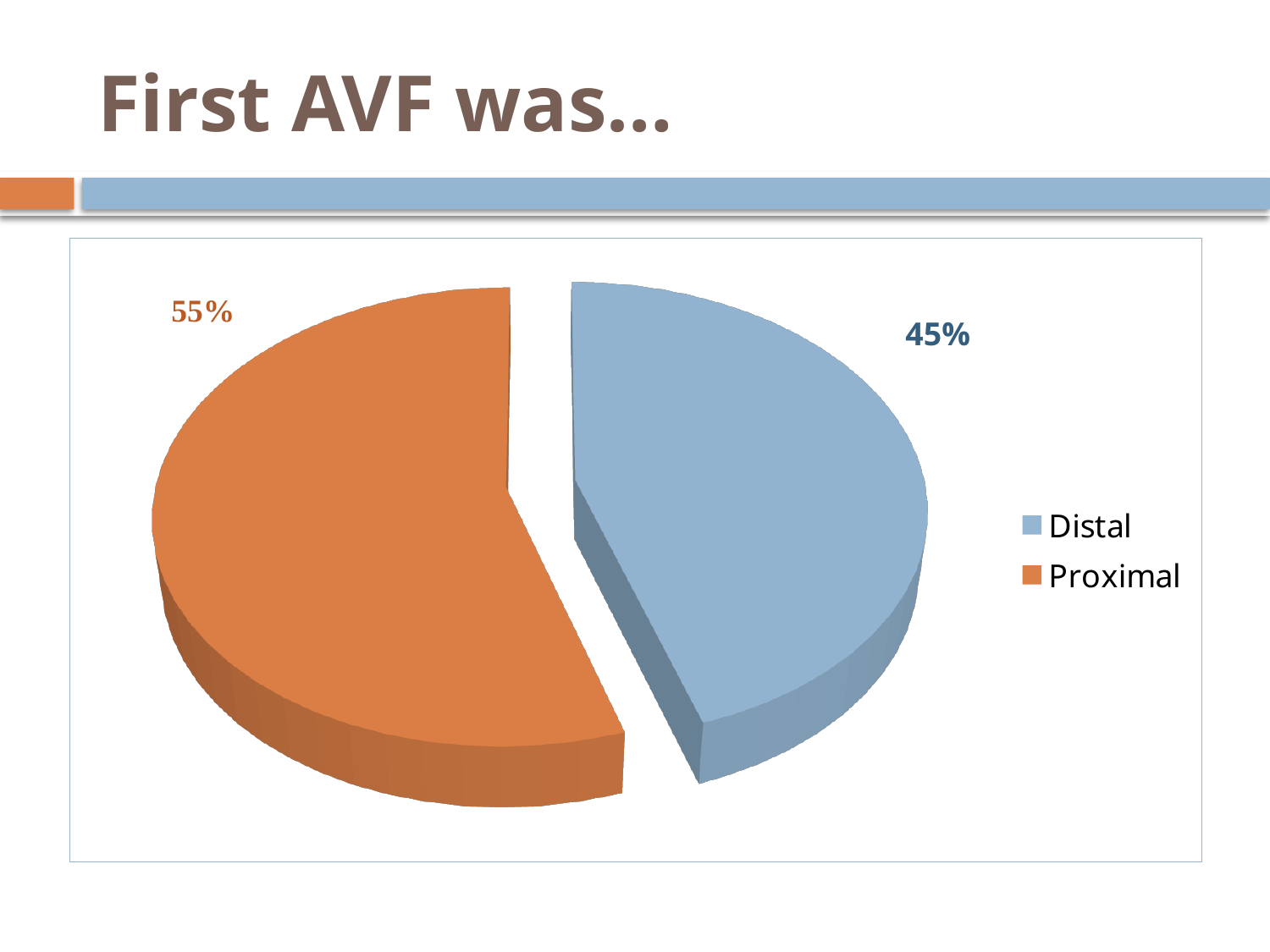
What kind of chart is shown on the slide? pie chart Is the Distal share larger or smaller than the Proximal share? smaller What is the difference in percentage points between the Proximal and Distal slices? 10 Which category has the smaller share of the pie? Distal What colour is the Distal slice in the pie chart? blue What percentage of first AVFs were Proximal? 55% What is the title of the slide containing the chart? First AVF was… How many categories does the pie chart show? 2 What share of the pie does the Proximal slice represent? 55% Is the Distal share greater or less than 50%? less Which category has the larger share of the pie? Proximal What percentage of first AVFs were Distal? 45%